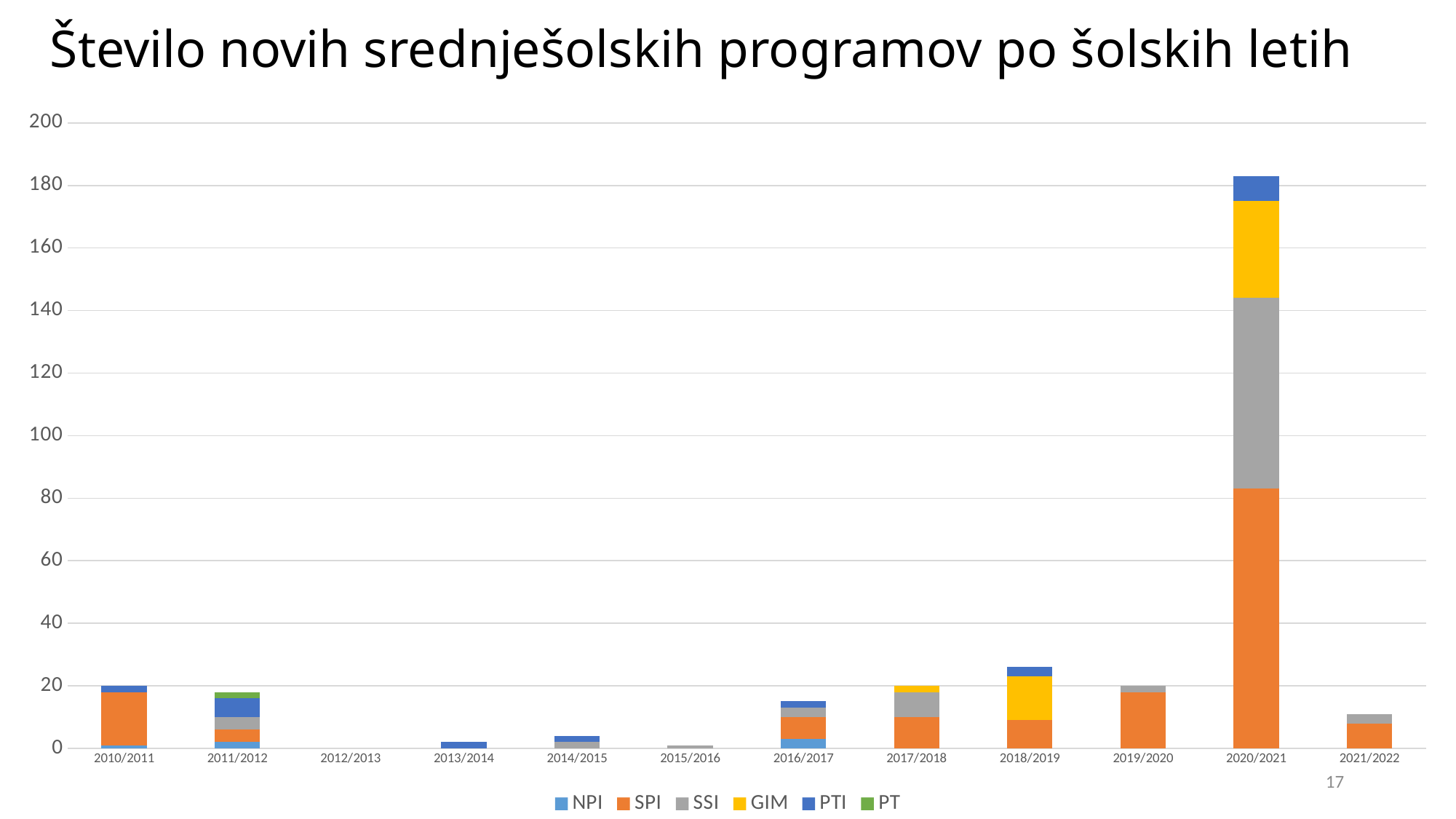
Is the total for 2018/2019 greater or less than 40? less Which school year shows no bar at all? 2012/2013 What kind of chart is shown on the slide? stacked bar chart Which has the larger total, 2019/2020 or 2020/2021? 2020/2021 Is the total for 2013/2014 greater or less than 20? less Which has the larger total, 2015/2016 or 2018/2019? 2018/2019 What is the title of the chart? Število novih srednješolskih programov po šolskih letih Which series is shown in yellow in the legend? GIM Which school year has the tallest bar? 2020/2021 How many series does the legend list? 6 Is the total for 2020/2021 greater or less than 160? greater How many school years are shown on the x axis? 12